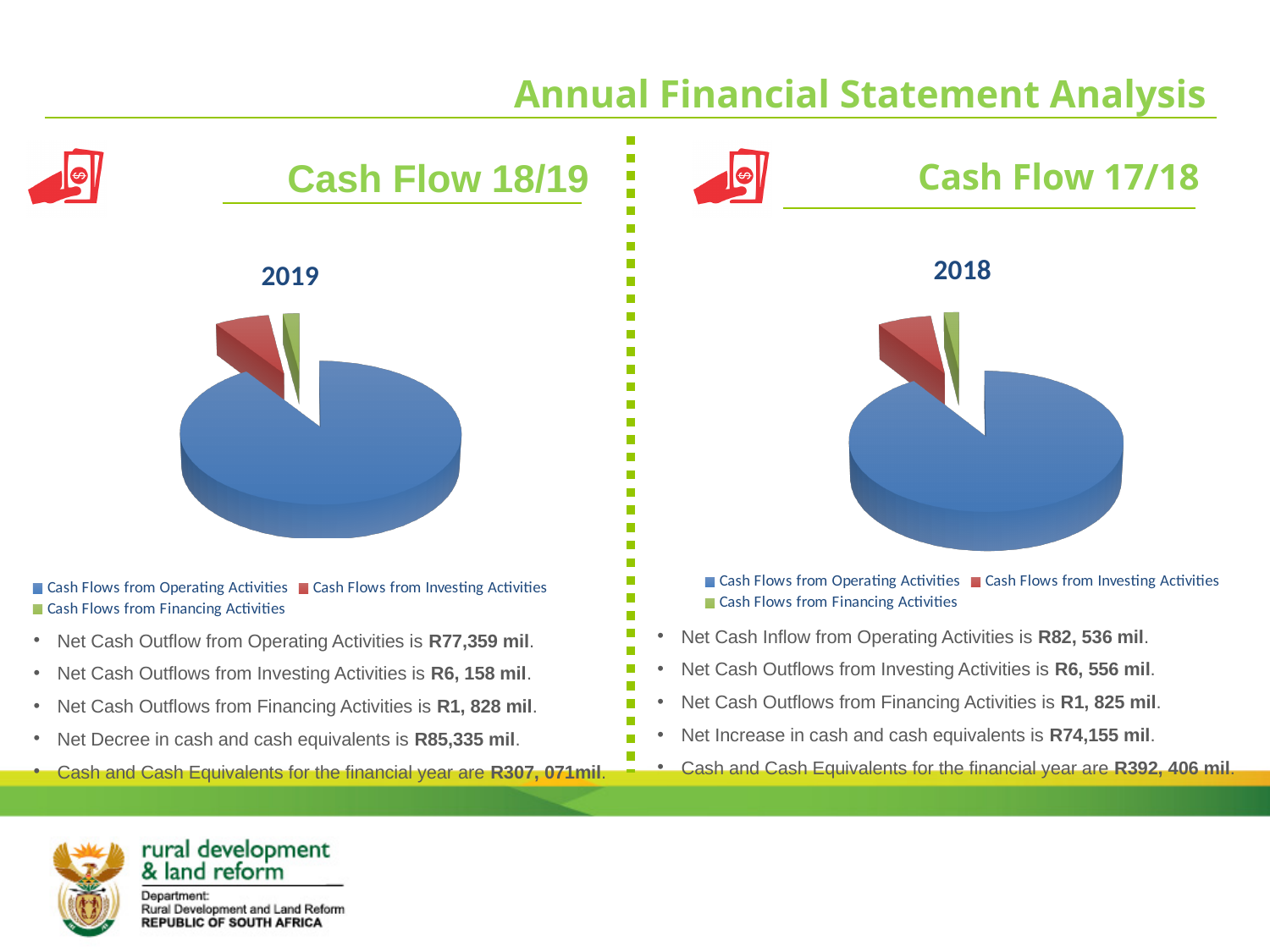
In the "2019" pie chart, how many slices are there? 3 In the "2019" pie chart, which category has the largest slice? Cash Flows from Operating Activities In the "2019" pie chart, which category has the smallest slice? Cash Flows from Financing Activities In the "2018" pie chart, which slice is larger: Cash Flows from Operating Activities or Cash Flows from Investing Activities? Cash Flows from Operating Activities In the "2018" pie chart, which category has the largest slice? Cash Flows from Operating Activities What is the title of the pie chart on the right side of the slide? 2018 What kind of chart is the chart titled "2018" on the right of the slide? Pie chart In the "2018" pie chart, which category has the smallest slice? Cash Flows from Financing Activities What is the title of the pie chart on the left side of the slide? 2019 In the "2019" pie chart, which slice is larger: Cash Flows from Investing Activities or Cash Flows from Financing Activities? Cash Flows from Investing Activities How many entries does the legend of the "2018" pie chart list? 3 What kind of chart is the chart titled "2019" on the left of the slide? Pie chart